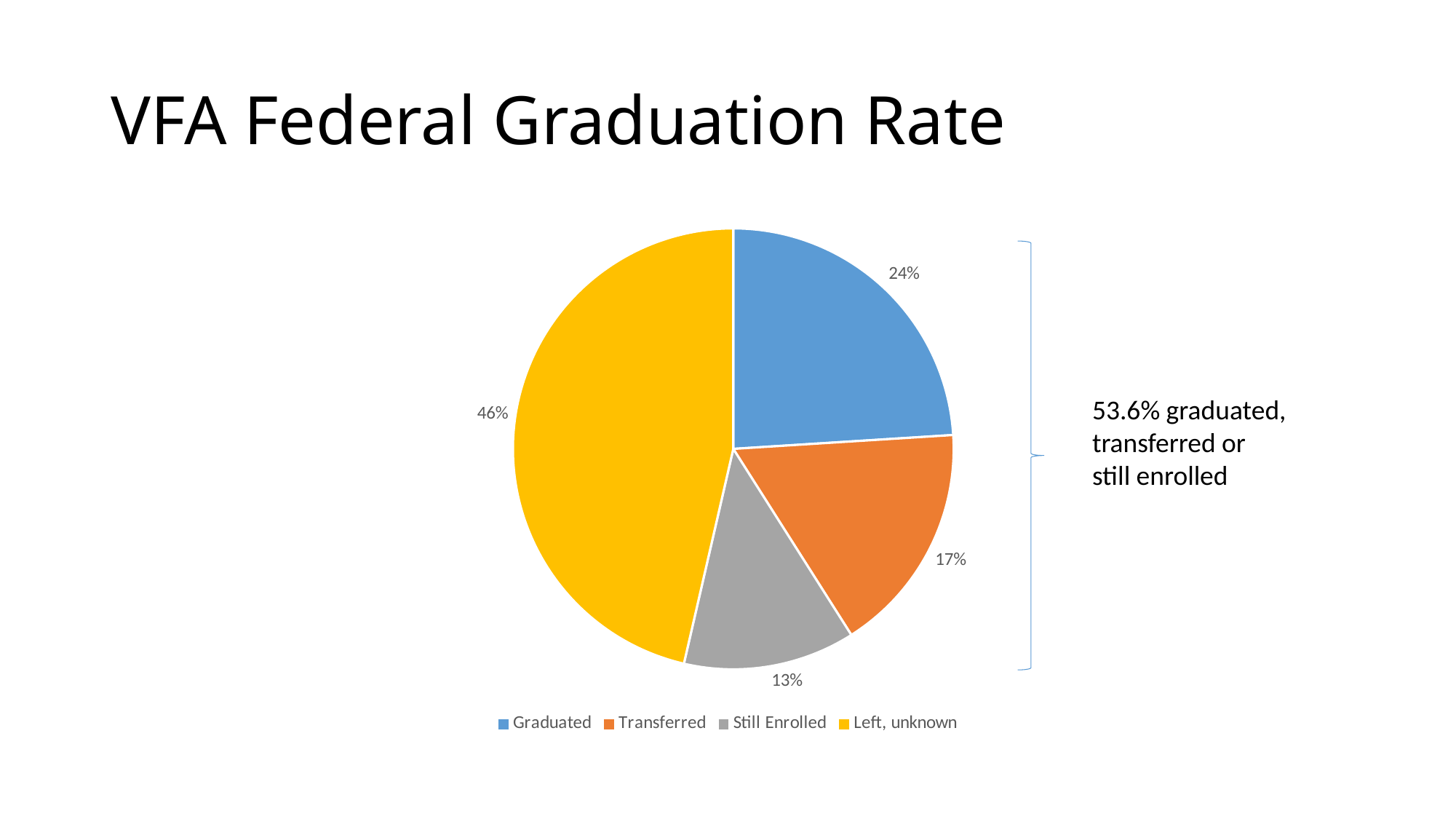
What share of the pie is labelled Transferred? 17% What is the title of the slide containing the pie chart? VFA Federal Graduation Rate How many categories does the pie chart show? 4 Which category has the smallest slice of the pie? Still Enrolled What share of the pie is labelled Graduated? 24% Which is larger, the Graduated slice or the Transferred slice? Graduated Which category has the largest slice of the pie? Left, unknown What colour is the Left, unknown slice of the pie? yellow What share of the pie is labelled Still Enrolled? 13% What is the difference in percentage points between the Left, unknown slice and the Graduated slice? 22 What kind of chart is shown on the slide? pie chart